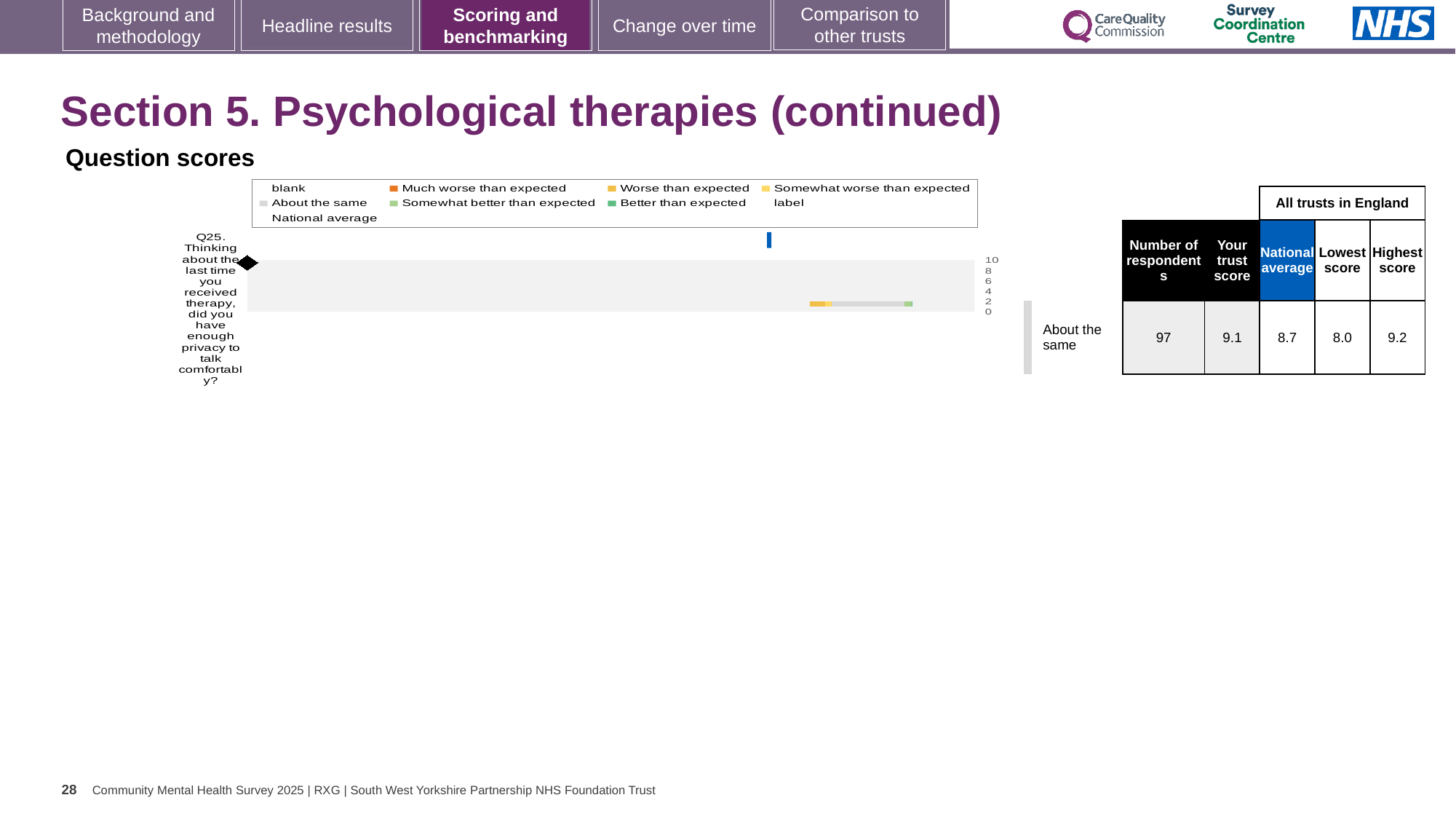
What is the national average score for Q25? 8.7 What is the trust's score for Q25? 9.1 How many respondents answered Q25? 97 Which is larger for Q25, the trust score or the national average? trust score How many survey questions are plotted on the chart? 1 What benchmark category is the trust's Q25 score placed in? About the same What is the highest value shown on the chart's axis? 10 What is the lowest score among all trusts in England for Q25? 8.0 What is the highest score among all trusts in England for Q25? 9.2 Which question number is plotted on the chart? Q25 What kind of chart is shown under 'Question scores'? bar chart What is the difference between the trust score and the national average for Q25? 0.4